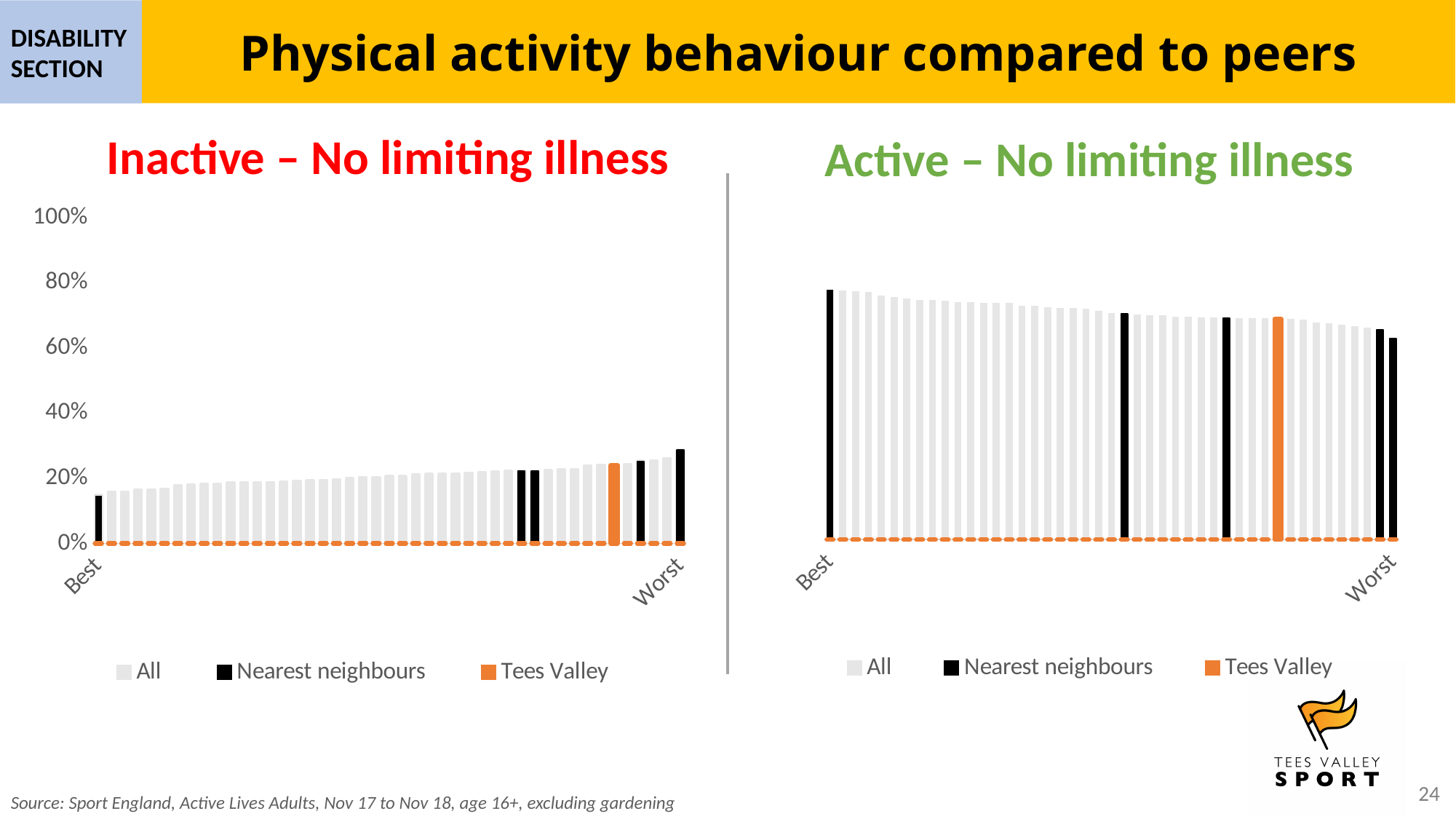
In the 'Inactive – No limiting illness' chart, do the bars rise or fall from Best to Worst? Rise How many series does the legend of the 'Active – No limiting illness' chart list? 3 In the 'Inactive – No limiting illness' chart, is the value for Tees Valley greater or less than 20%? greater In the 'Active – No limiting illness' chart, do the bars rise or fall from Best to Worst? Fall What type of chart is the 'Inactive – No limiting illness' chart on the left? Bar chart Which series is shown in orange in both charts? Tees Valley In the 'Inactive – No limiting illness' chart, is the Tees Valley bar taller or shorter than the tallest Nearest neighbours bar? Shorter How many series does the legend of the 'Inactive – No limiting illness' chart list? 3 In the 'Inactive – No limiting illness' chart, is the value for Tees Valley greater or less than 40%? less What type of chart is the 'Active – No limiting illness' chart on the right? Bar chart What is the title of the chart on the right of the slide? Active – No limiting illness